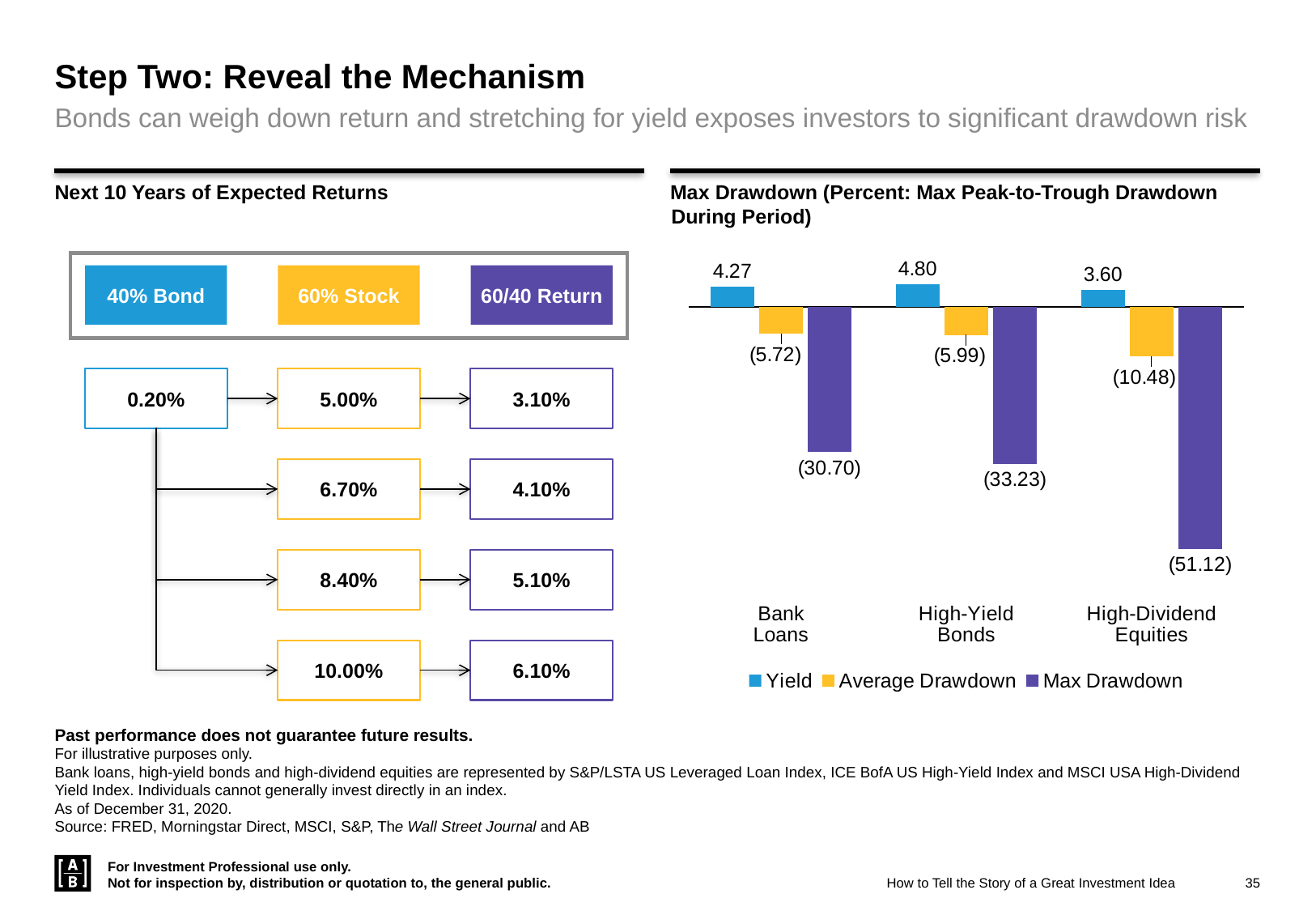
In the Max Drawdown chart, which category has the largest Max Drawdown? High-Dividend Equities How many categories are shown on the x axis of the Max Drawdown chart? 3 In the Max Drawdown chart, is the Average Drawdown larger in magnitude for High-Dividend Equities or for Bank Loans? High-Dividend Equities In the Max Drawdown chart, what is the Yield value for Bank Loans? 4.27 In the Max Drawdown chart, what is the Max Drawdown value for Bank Loans? (30.70) What kind of chart is the Max Drawdown chart? Bar chart In the Max Drawdown chart, which category has the highest Yield? High-Yield Bonds In the Max Drawdown chart, what is the Average Drawdown value for High-Yield Bonds? (5.99) In the Max Drawdown chart, which category has the lowest Yield? High-Dividend Equities In the Max Drawdown chart, what is the difference between the Yield for High-Yield Bonds and the Yield for Bank Loans? 0.53 How many series does the legend of the Max Drawdown chart list? 3 In the Max Drawdown chart, what is the Max Drawdown value for High-Dividend Equities? (51.12)